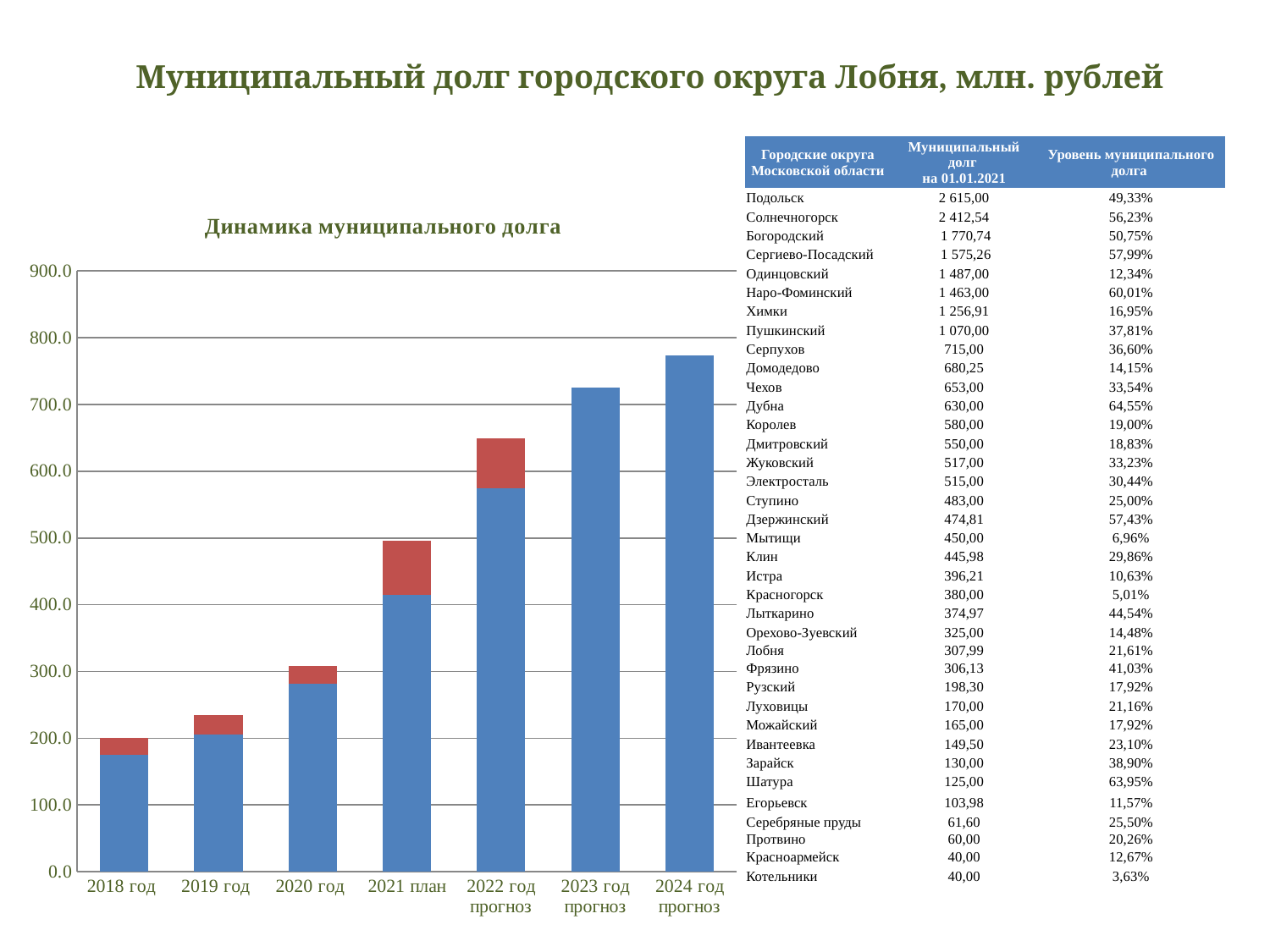
In the chart 'Динамика муниципального долга', is the total bar for 2021 план greater or less than 600.0? less In the chart 'Динамика муниципального долга', is the total bar for 2023 год прогноз greater or less than 600.0? greater What is the title of the chart on the slide? Динамика муниципального долга How many categories are shown on the x axis of the chart 'Динамика муниципального долга'? 7 In the chart 'Динамика муниципального долга', which bar is taller: 2022 год прогноз or 2020 год? 2022 год прогноз In the chart 'Динамика муниципального долга', is the total bar for 2024 год прогноз greater or less than 700.0? greater In the chart 'Динамика муниципального долга', do the bar totals rise or fall from 2018 год to 2024 год прогноз? rise Which category has the shortest bar in the chart 'Динамика муниципального долга'? 2018 год Which category has the tallest bar in the chart 'Динамика муниципального долга'? 2024 год прогноз What kind of chart is 'Динамика муниципального долга'? bar chart